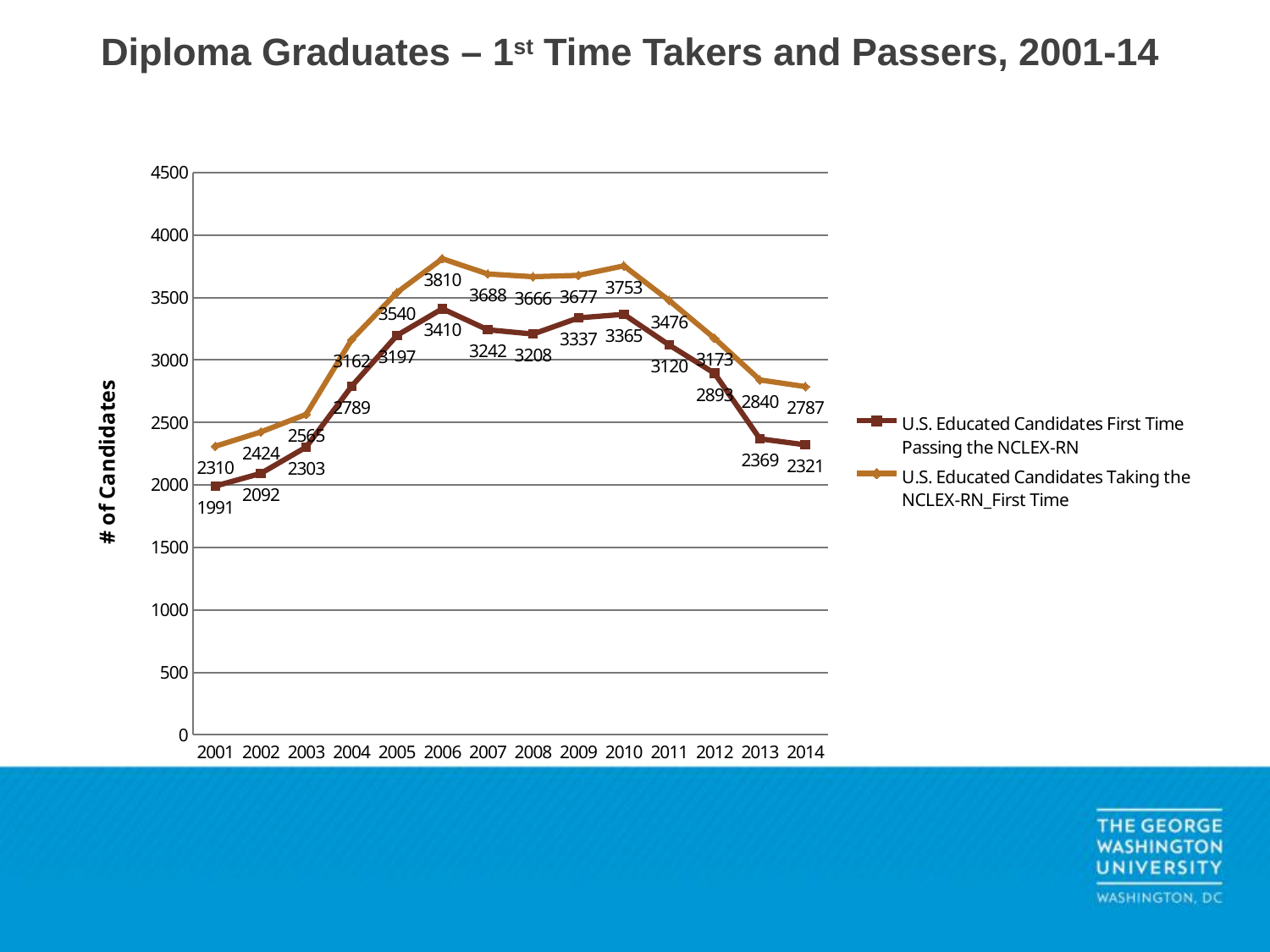
What kind of chart is shown on the slide? Line chart What is the value for U.S. Educated Candidates First Time Passing the NCLEX-RN in 2001? 1991 What is the value for U.S. Educated Candidates First Time Passing the NCLEX-RN in 2014? 2321 In which year is the number of U.S. Educated Candidates Taking the NCLEX-RN_First Time highest? 2006 In 2006, what is the difference between the number of candidates taking the NCLEX-RN for the first time and the number passing? 400 Is the value for U.S. Educated Candidates Taking the NCLEX-RN_First Time in 2005 greater or less than 3500? greater Do the values for U.S. Educated Candidates First Time Passing the NCLEX-RN rise or fall from 2010 to 2014? Fall How many series does the legend list? 2 For U.S. Educated Candidates First Time Passing the NCLEX-RN, which year has the larger value, 2009 or 2010? 2010 What is the value for U.S. Educated Candidates Taking the NCLEX-RN_First Time in 2006? 3810 In which year is the number of U.S. Educated Candidates First Time Passing the NCLEX-RN lowest? 2001 How many years are shown on the x axis? 14